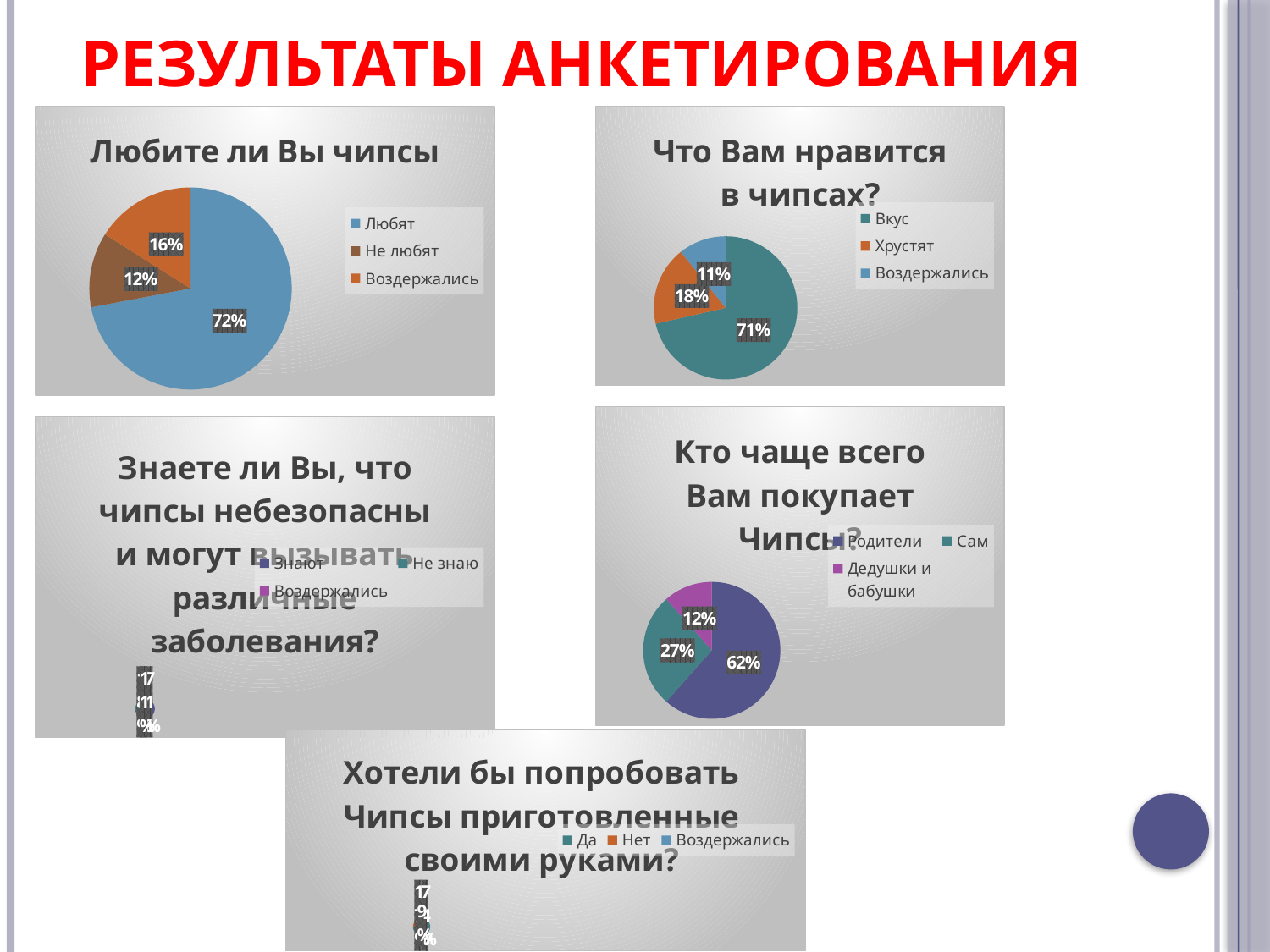
In the chart titled "Что Вам нравится в чипсах?", how many entries does the legend list? 3 In the chart titled "Что Вам нравится в чипсах?", what percentage is shown for "Вкус"? 71% In the chart titled "Что Вам нравится в чипсах?", what percentage is shown for "Хрустят"? 18% In the chart titled "Кто чаще всего Вам покупает Чипсы?", what percentage is shown for "Родители"? 62% In the chart titled "Любите ли Вы чипсы", what is the difference between the shares for "Любят" and "Воздержались"? 56% In the chart titled "Что Вам нравится в чипсах?", which category has the largest share? Вкус In the chart titled "Кто чаще всего Вам покупает Чипсы?", which is larger, the share for "Сам" or for "Дедушки и бабушки"? Сам What type of chart is the one titled "Любите ли Вы чипсы"? Pie chart In the chart titled "Любите ли Вы чипсы", what percentage is shown for "Не любят"? 12% In the chart titled "Любите ли Вы чипсы", which category has the smallest share? Не любят In the chart titled "Кто чаще всего Вам покупает Чипсы?", what is the difference between the shares for "Родители" and "Сам"? 35% In the chart titled "Любите ли Вы чипсы", what percentage is shown for "Любят"? 72%